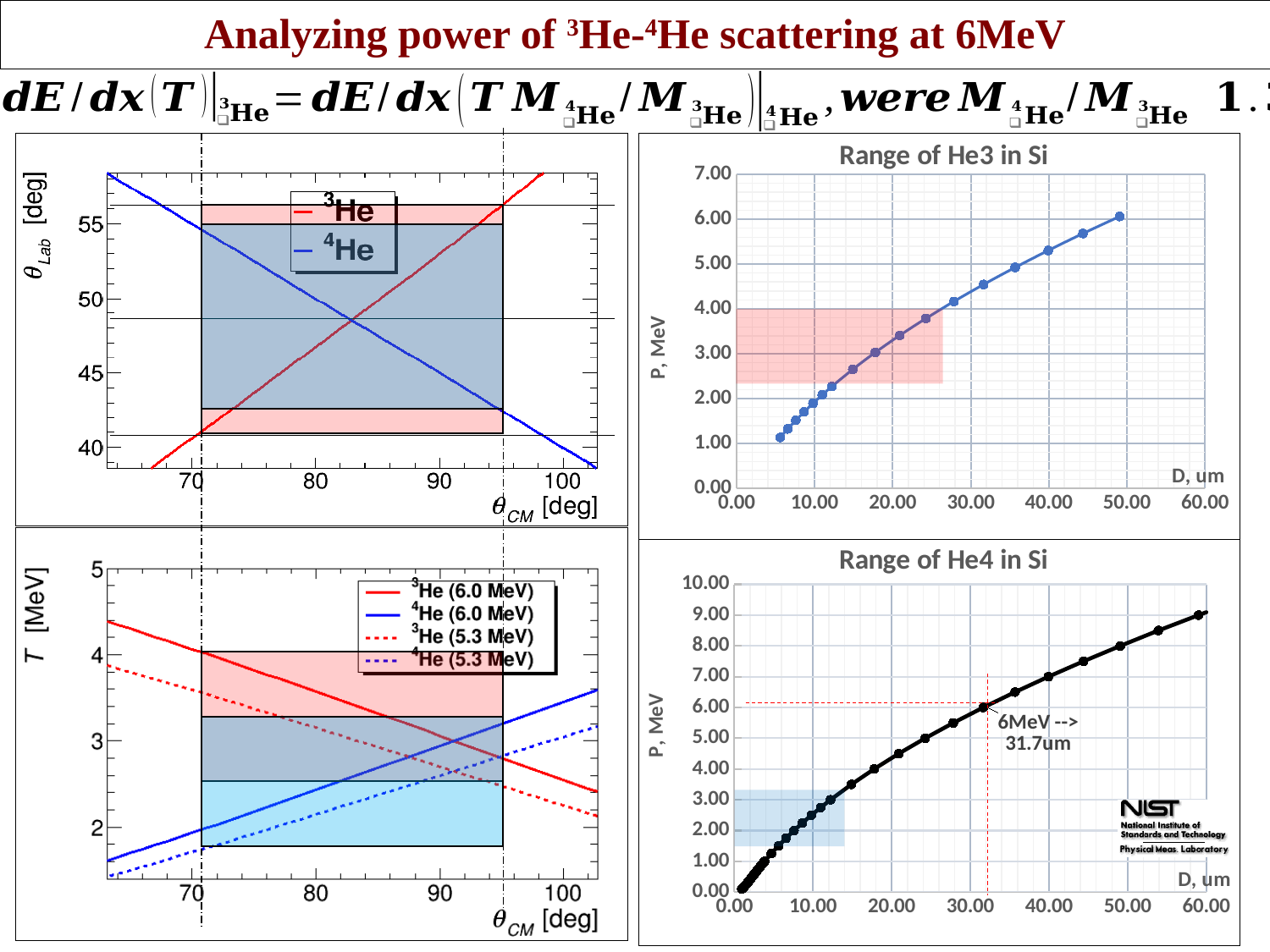
In the 'Range of He3 in Si' chart, is the value of P at D = 40.00 um greater or less than 5.00? greater What kind of chart is the 'Range of He4 in Si' chart? line chart According to the annotation on the 'Range of He4 in Si' chart, what range in Si corresponds to 6 MeV? 31.7um In the 'Range of He3 in Si' chart, does P rise or fall as D increases? rises What is the label of the y axis on the 'Range of He3 in Si' chart? P, MeV In the bottom-left chart (T vs θ_CM), does the 3He (6.0 MeV) line rise or fall as θ_CM increases? falls In the 'Range of He4 in Si' chart, does P rise or fall as D increases? rises How many series does the legend of the top-left chart (θ_Lab vs θ_CM) list? 2 In the 'Range of He4 in Si' chart, is the value of P at D = 20.00 um greater or less than 4.00? greater What is the title of the top-right chart? Range of He3 in Si How many series does the legend of the bottom-left chart (T vs θ_CM) list? 4